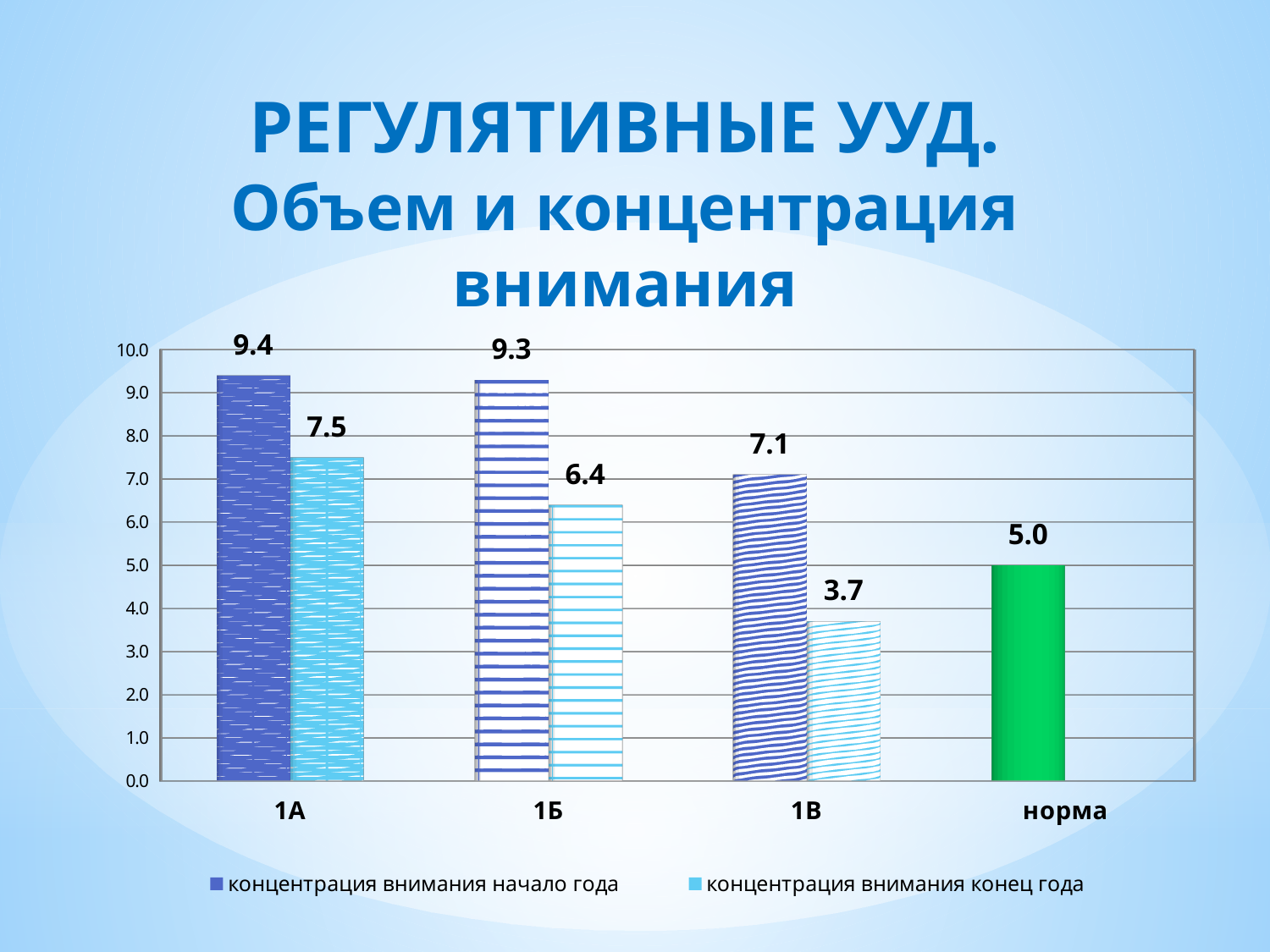
What is the difference between the start-of-year and end-of-year values for 1В? 3.4 What value is shown for the category "норма"? 5.0 Which category has the highest value in the series "концентрация внимания начало года"? 1А Is the end-of-year value for 1А greater or less than 7.0? greater What kind of chart is shown on the slide? bar chart Which category has the lowest value in the series "концентрация внимания конец года"? 1В What is the value for 1В in the series "концентрация внимания конец года"? 3.7 Which is larger for 1Б: the start-of-year value or the end-of-year value? концентрация внимания начало года (9.3) What is the value for 1А in the series "концентрация внимания начало года"? 9.4 How many series does the legend list? 2 How many categories are shown on the x axis? 4 What is the value for 1Б in the series "концентрация внимания конец года"? 6.4